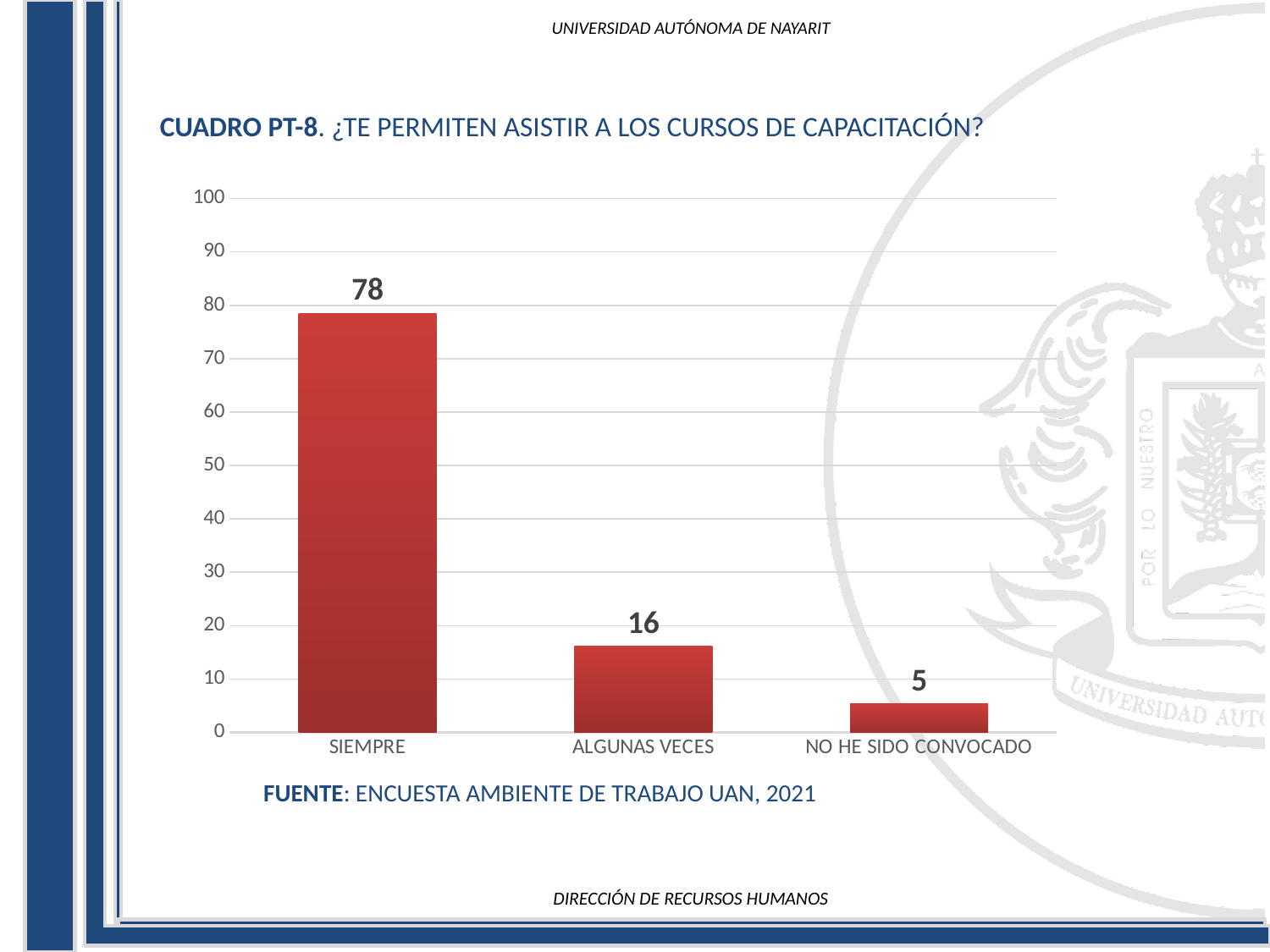
What is the difference between the values for ALGUNAS VECES and NO HE SIDO CONVOCADO? 11 What is the difference between the values for SIEMPRE and ALGUNAS VECES? 62 How many categories are shown on the x axis? 3 What is the value for NO HE SIDO CONVOCADO? 5 Is the value for SIEMPRE greater or less than 70? greater What is the value for SIEMPRE? 78 What kind of chart is shown on the slide? bar chart What is the source cited below the chart? ENCUESTA AMBIENTE DE TRABAJO UAN, 2021 Which is larger, the value for ALGUNAS VECES or the value for NO HE SIDO CONVOCADO? ALGUNAS VECES Which category has the highest value? SIEMPRE What is the value for ALGUNAS VECES? 16 Which category has the lowest value? NO HE SIDO CONVOCADO